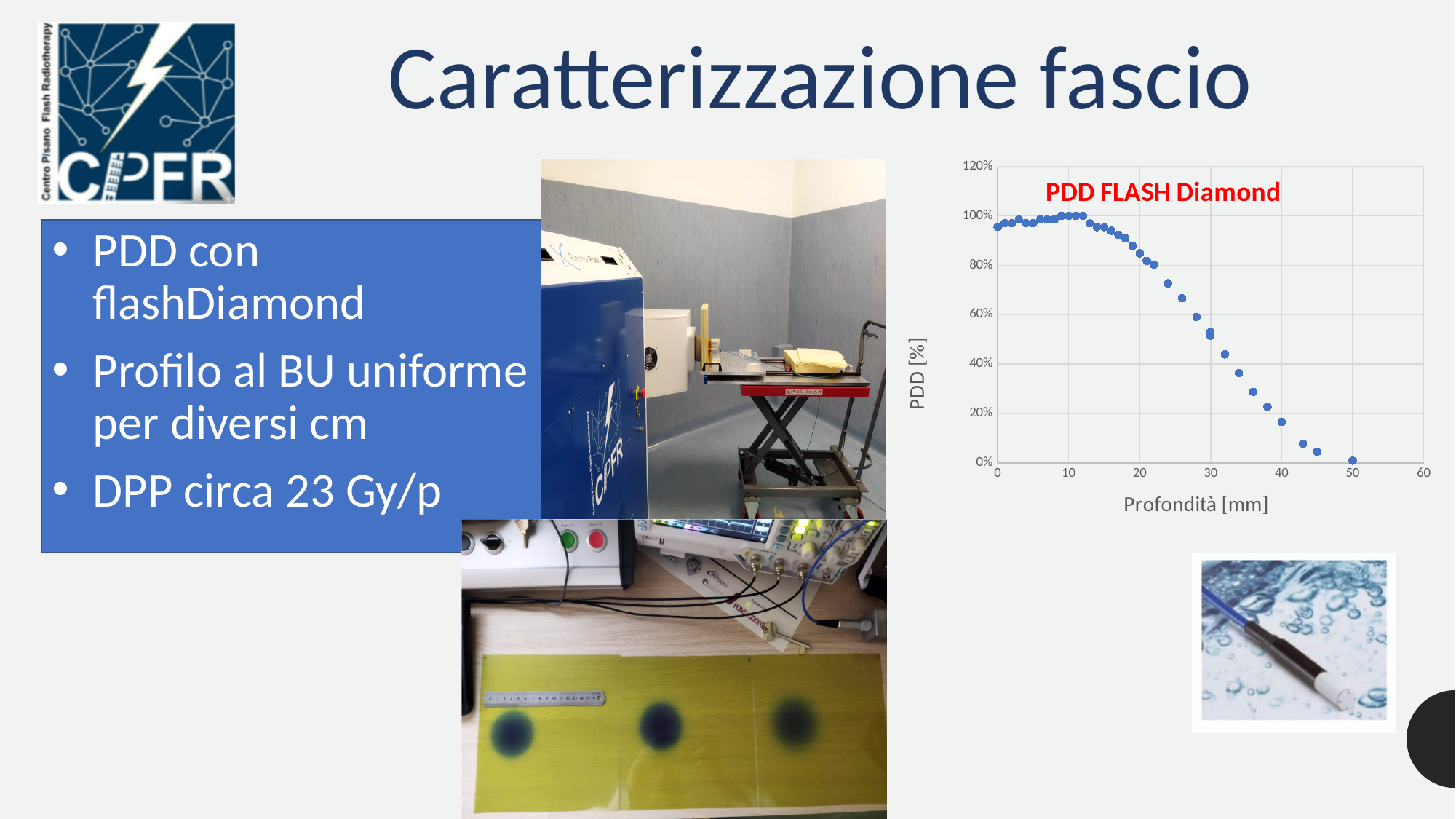
Which has the larger PDD value, the point at 10 mm or the point at 30 mm? 10 mm What is the label of the x axis of the chart? Profondità [mm] Is the PDD value at a depth of 10 mm greater or less than 80%? greater What is the title of the chart? PDD FLASH Diamond Is the PDD value at a depth of 40 mm greater or less than 20%? less Is the PDD value at a depth of 20 mm greater or less than 80%? greater Do the PDD values rise or fall along the x axis beyond a depth of about 10 mm? fall Which has the larger PDD value, the point at 45 mm or the point at 20 mm? 20 mm What kind of chart is shown on the slide? scatter chart